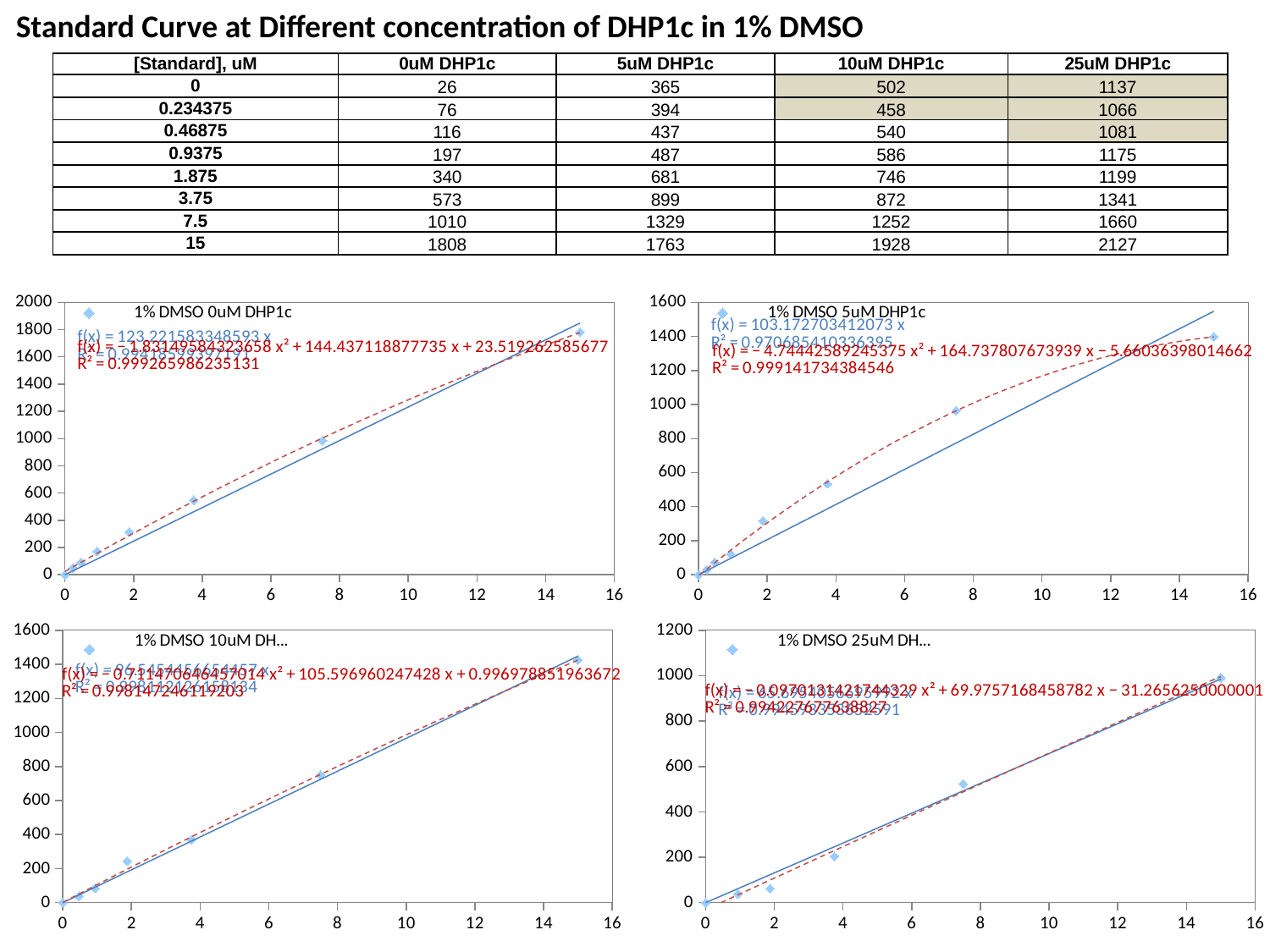
In the top-left chart (1% DMSO 0uM DHP1c), do the plotted values rise or fall as x increases? rise In the bottom-left chart (1% DMSO 10uM DH...), is the value of the point at x = 15 greater or less than 1200? greater In the top-right chart (1% DMSO 5uM DHP1c), what R² value is shown in blue for the linear trendline? 0.970685410336395 In the bottom-right chart (1% DMSO 25uM DH...), do the plotted values rise or fall along the x axis? rise In the bottom-right chart (1% DMSO 25uM DH...), is the value of the point at x = 7.5 greater or less than 400? greater What kind of chart is the top-left chart titled '1% DMSO 0uM DHP1c'? scatter chart In the bottom-right chart (1% DMSO 25uM DH...), is the value of the point at x = 15 greater or less than 800? greater What is the maximum value shown on the y axis of the top-left chart (1% DMSO 0uM DHP1c)? 2000